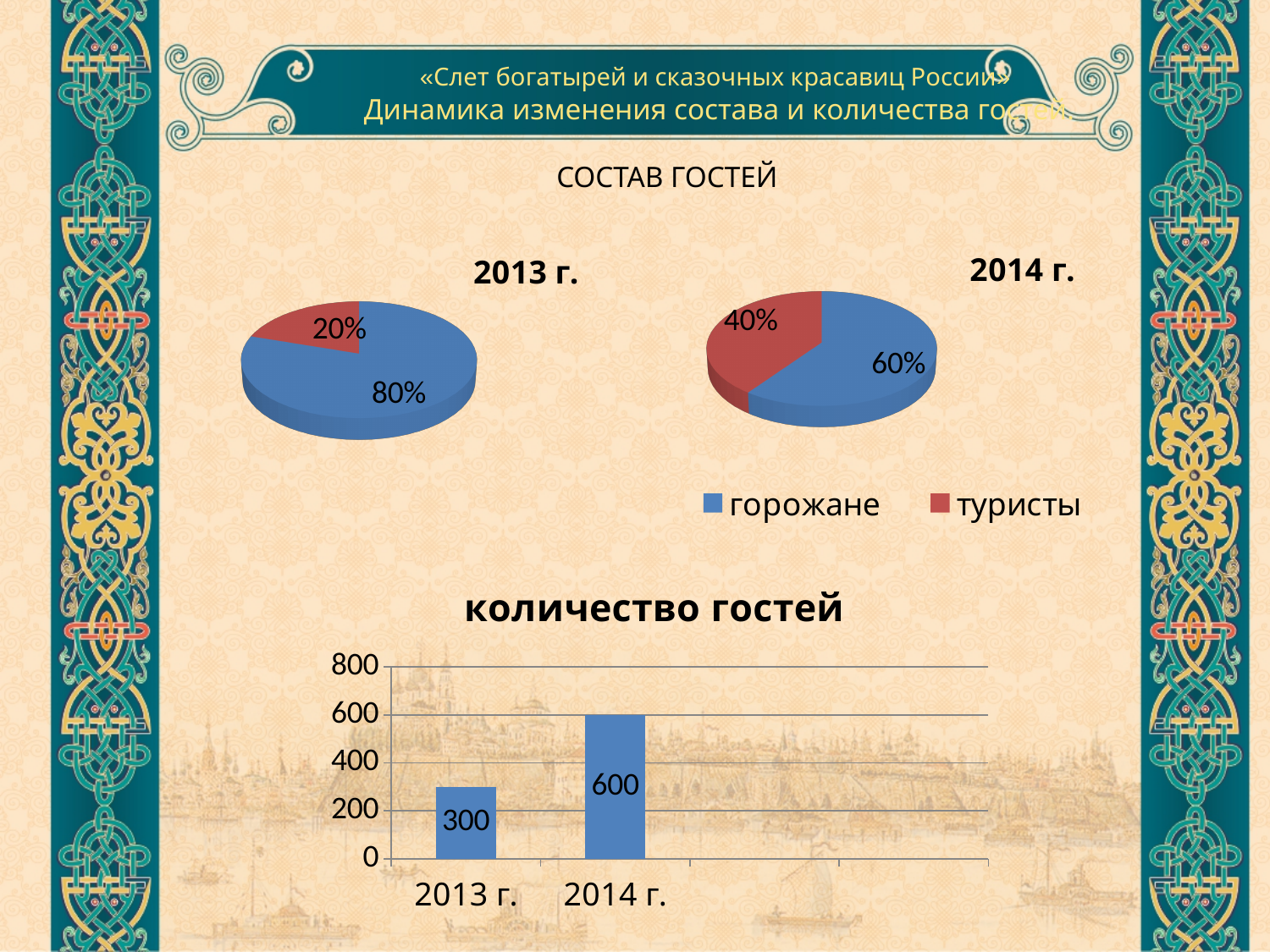
In the 'количество гостей' chart, what is the value for 2014 г.? 600 In the 2013 г. pie chart, what is the difference between the горожане share and the туристы share? 60% In the 2014 г. pie chart, which category has the larger share, горожане or туристы? горожане In the 2014 г. pie chart, what share of guests were горожане? 60% In the 2014 г. pie chart, what share of guests were туристы? 40% In the 2013 г. pie chart, what share of guests were горожане? 80% How many entries does the legend under the pie charts list? 2 In the 'количество гостей' chart, what is the difference between the values for 2014 г. and 2013 г.? 300 In the 'количество гостей' chart, which year has the highest value? 2014 г. In the 2013 г. pie chart, what share of guests were туристы? 20% What kind of chart is the 'количество гостей' chart? bar chart In the 'количество гостей' chart, what is the value for 2013 г.? 300